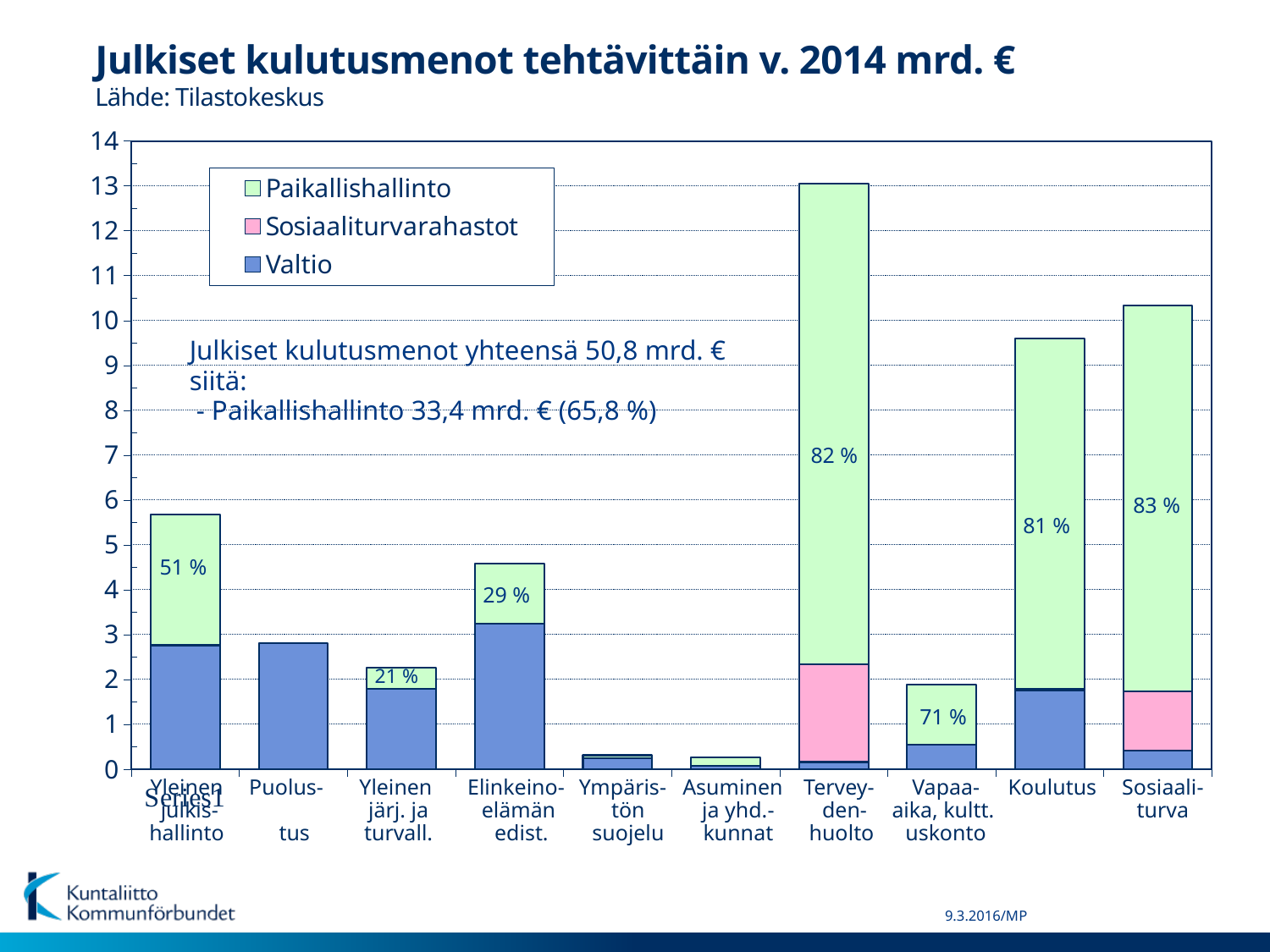
How many categories are shown on the x axis? 10 What percentage label is shown on the Elinkeinoelämän edist. bar? 29 % Which category has the highest total bar? Terveydenhuolto What percentage label is shown on the Terveydenhuolto bar? 82 % Is the total for Terveydenhuolto greater or less than 12? greater How many series does the legend list? 3 What percentage label is shown on the Sosiaaliturva bar? 83 % What percentage label is shown on the Koulutus bar? 81 % Which series is shown in green in the legend? Paikallishallinto What kind of chart is shown on the slide? Stacked bar chart What percentage label is shown on the Yleinen julkishallinto bar? 51 % Which total bar is taller, Koulutus or Sosiaaliturva? Sosiaaliturva